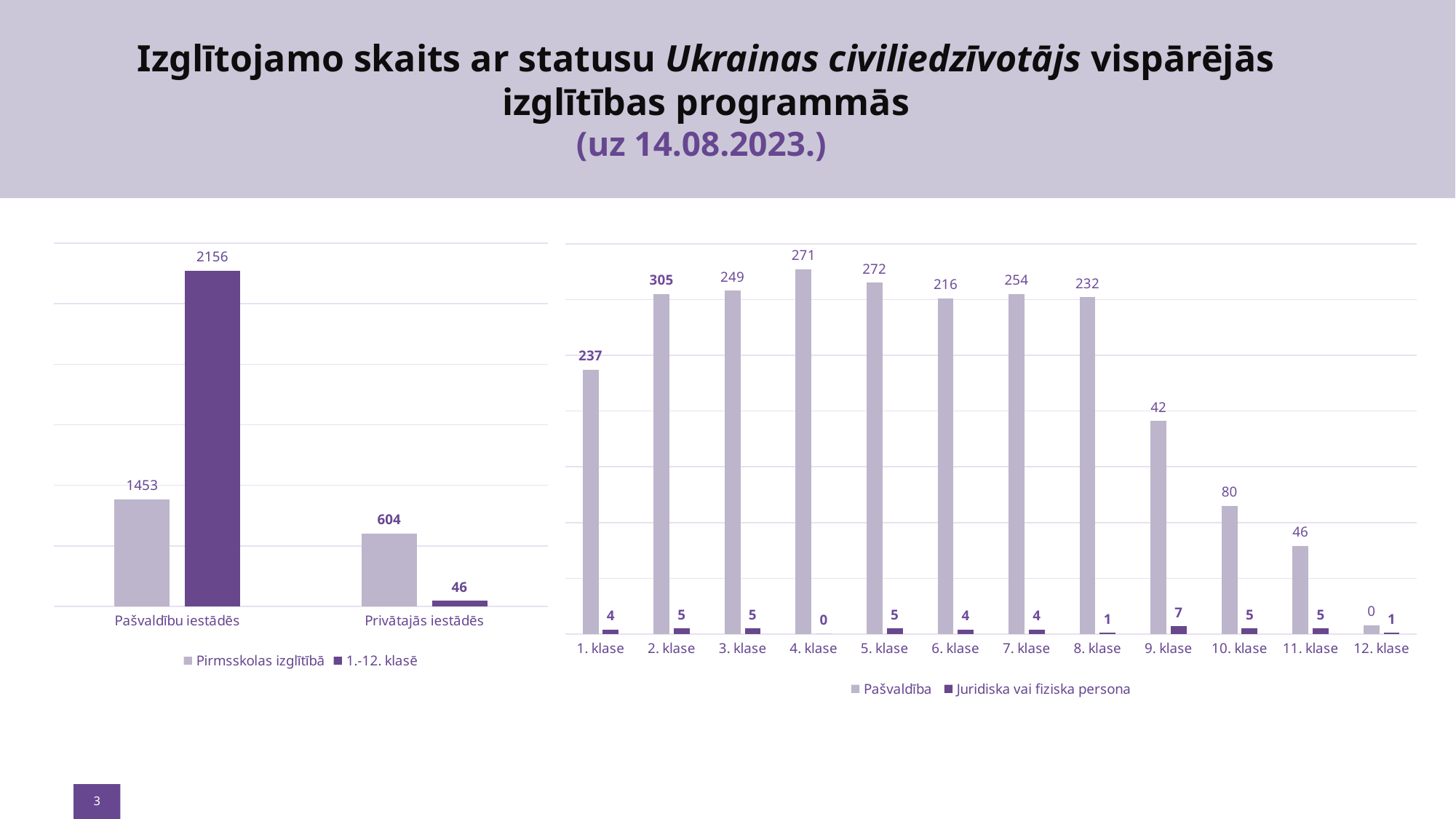
How many series does the legend of the left chart list? 2 In the right chart, what is the Pašvaldība value for 4. klase? 271 In the left chart, what is the value for 1.-12. klasē in Pašvaldību iestādēs? 2156 In the right chart, which class has the lowest Pašvaldība value? 12. klase In the left chart, what is the difference between the two series for Pašvaldību iestādēs? 703 How many classes are shown on the x axis of the right chart? 12 In the left chart, which is larger for Privātajās iestādēs: Pirmsskolas izglītībā or 1.-12. klasē? Pirmsskolas izglītībā In the right chart, which class has the highest Pašvaldība value? 2. klase In the right chart, what is the Juridiska vai fiziska persona value for 9. klase? 7 In the right chart, what is the difference between the Pašvaldība values for 8. klase and 9. klase? 190 What type of chart is the right chart? Bar chart In the left chart, what is the value for Pirmsskolas izglītībā in Privātajās iestādēs? 604